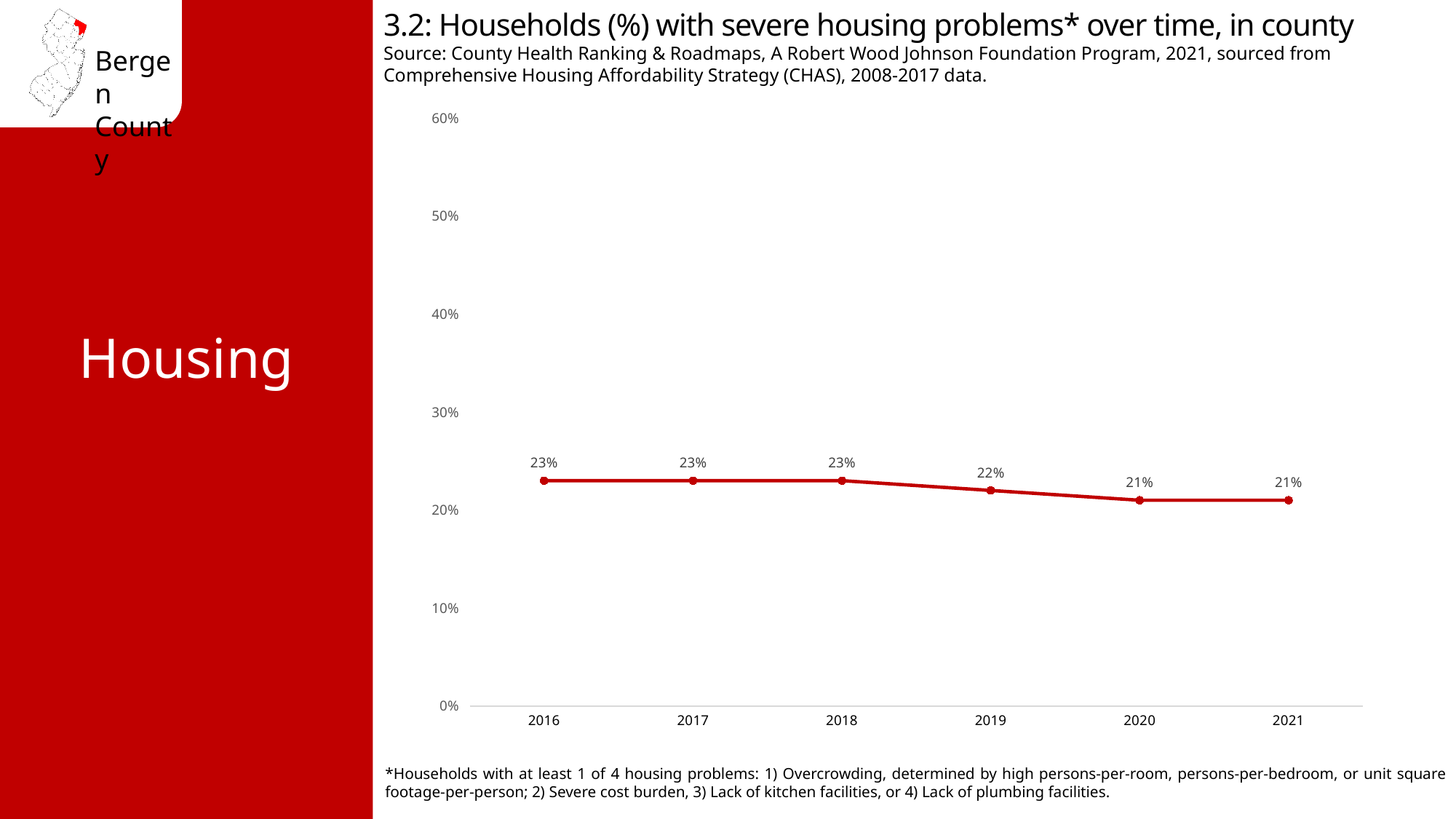
What is the difference between the 2016 value and the 2021 value? 2% What is the value shown for 2020? 21% What is the value shown for 2019? 22% What is the title of the chart? 3.2: Households (%) with severe housing problems* over time, in county Is the value for 2018 greater or less than 20%? greater What percentage of households had severe housing problems in 2016? 23% How many years are plotted on the chart? 6 Do the values rise or fall from 2016 to 2021? Fall What percentage of households had severe housing problems in 2021? 21% Is the value for 2021 greater or less than 30%? less Which year has the lowest value on the chart, 2019 or 2020? 2020 What kind of chart is shown on the slide? Line chart